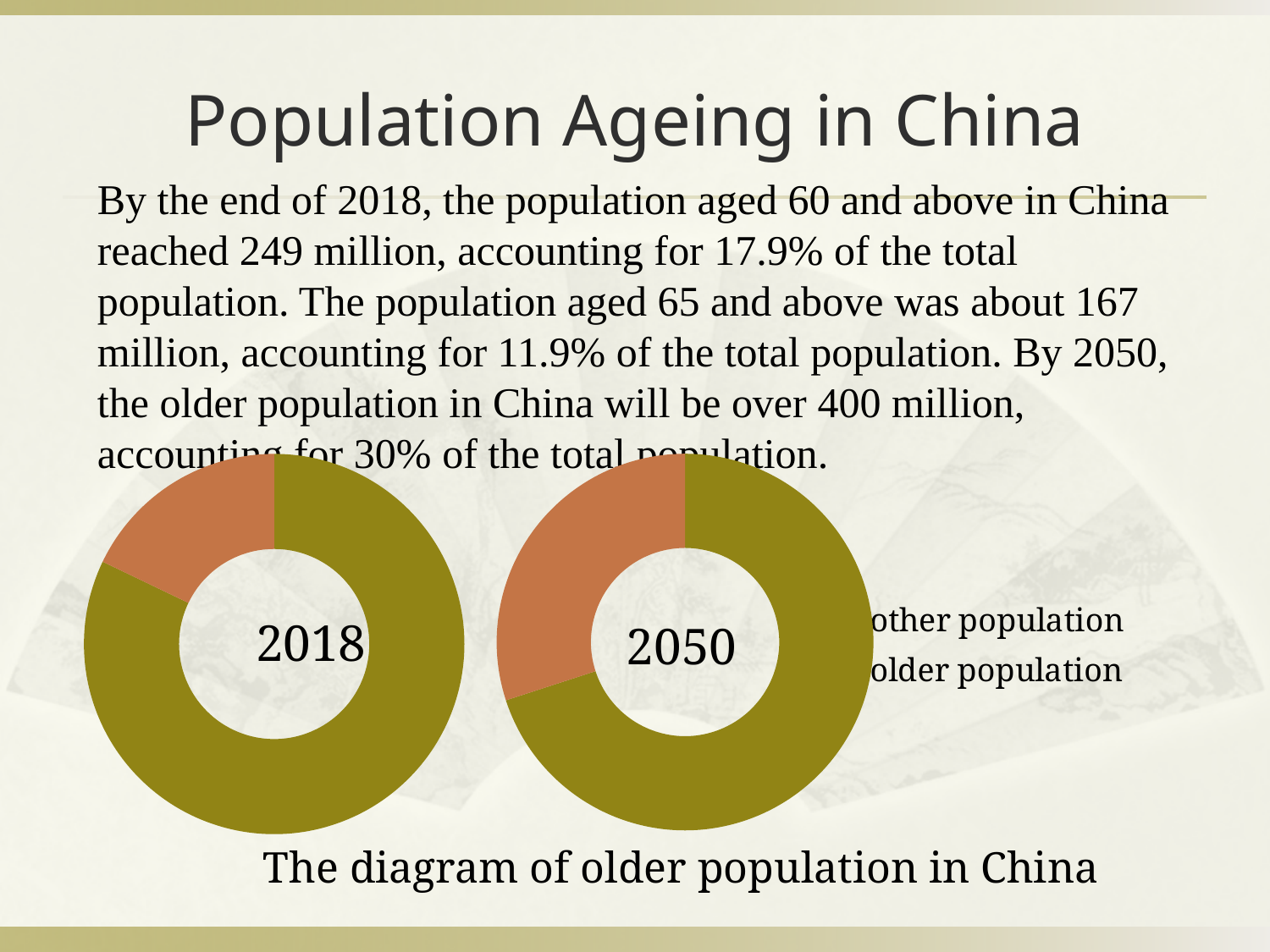
What kind of chart is used to show the population breakdown for 2018 and 2050? doughnut (pie) chart How many slices does each doughnut chart contain? 2 What caption is printed below the two doughnut charts? The diagram of older population in China In the 2018 doughnut chart, which category takes the larger share: other population or older population? other population How many doughnut charts are shown on the slide? 2 Comparing the two doughnut charts, is the older population share larger in 2018 or in 2050? 2050 In the 2050 doughnut chart, which category takes the larger share: other population or older population? other population From the 2018 chart to the 2050 chart, does the share of older population rise or fall? rise What years are labelled in the centres of the left and right doughnut charts? 2018 and 2050 What are the two categories listed in the legend of the doughnut charts? other population, older population In the 2050 doughnut chart, which category has the smallest slice? older population How many entries does the legend of the doughnut charts list? 2